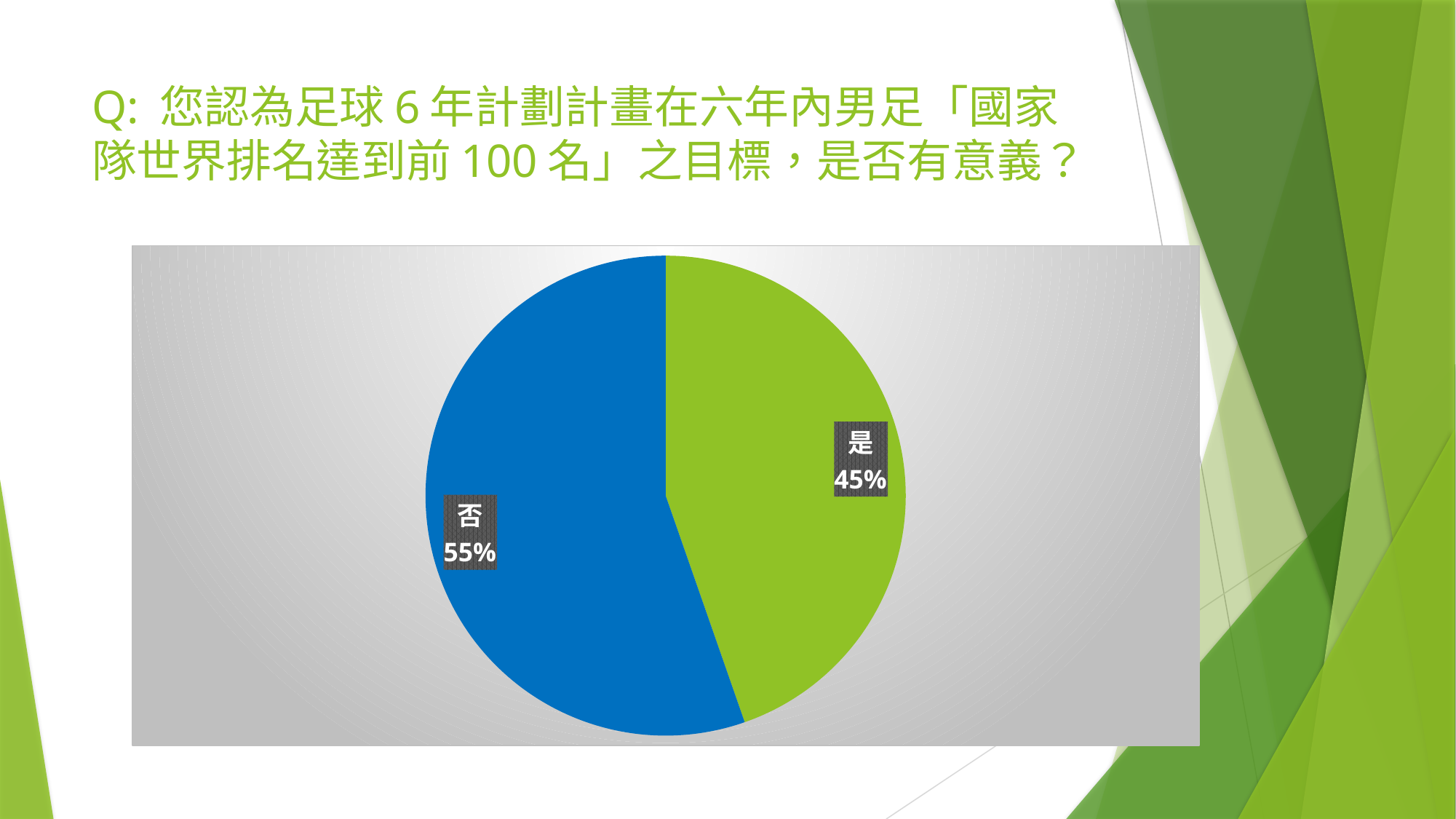
What colour is the 否 slice of the pie? blue What colour is the 是 slice of the pie? green Which slice is larger, 是 or 否? 否 What kind of chart is shown on the slide? pie chart Which slice of the pie is the largest? 否 How many slices does the pie chart have? 2 What is the difference in percentage points between the 否 slice and the 是 slice? 10% What percentage of the pie is labelled 否? 55% Which slice of the pie is the smallest? 是 What share of the pie does the 否 slice represent? 55% What percentage of the pie is labelled 是? 45%